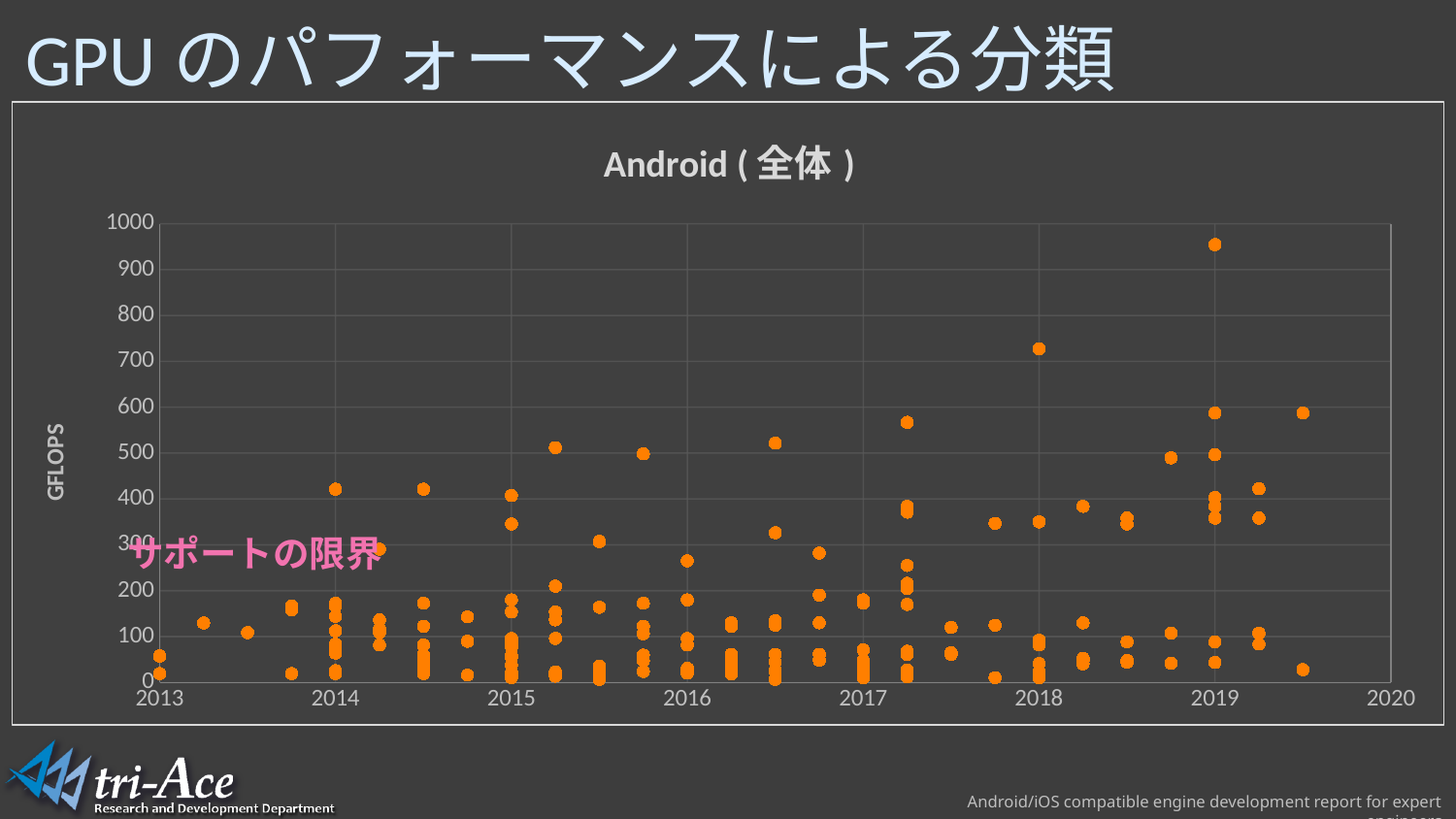
What is the label on the vertical axis of the chart? GFLOPS Which year has a lower maximum plotted value, 2013 or 2015? 2013 What kind of chart is shown on the slide? scatter chart Does the maximum plotted GFLOPS value generally rise or fall from 2013 to 2019? rise In which year does the highest plotted point appear? 2019 Is the highest plotted point in 2019 greater or less than 900 GFLOPS? greater What is the title of the chart? Android ( 全体 ) Is the highest plotted point in 2018 greater or less than 700 GFLOPS? greater Which year has a higher maximum plotted value, 2018 or 2019? 2019 Is the highest plotted point in 2014 greater or less than 400 GFLOPS? greater